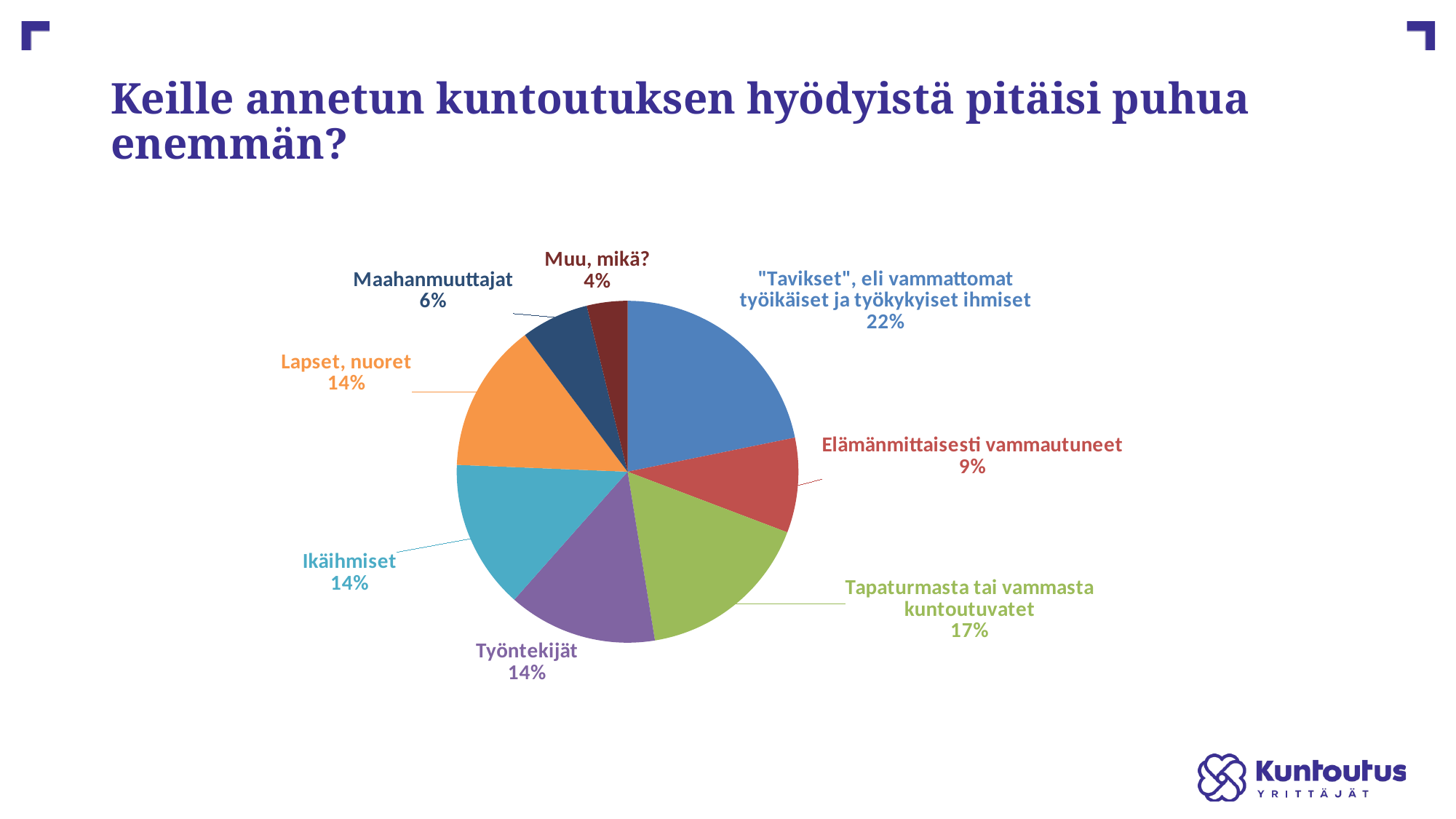
What kind of chart is shown on the slide? pie chart Which category has the smallest share of the pie? Muu, mikä? What share of the pie is labelled "Tavikset", eli vammattomat työikäiset ja työkykyiset ihmiset? 22% Which category has the largest share of the pie? "Tavikset", eli vammattomat työikäiset ja työkykyiset ihmiset What percentage is shown for Elämänmittaisesti vammautuneet? 9% How many slices does the pie chart have? 8 What is the title of the slide containing the pie chart? Keille annetun kuntoutuksen hyödyistä pitäisi puhua enemmän? What percentage is shown for Maahanmuuttajat? 6% What is the difference in percentage points between "Tavikset" (22%) and Tapaturmasta tai vammasta kuntoutuvatet (17%)? 5 percentage points Which is larger, the share for Elämänmittaisesti vammautuneet or the share for Maahanmuuttajat? Elämänmittaisesti vammautuneet What is the combined share of Lapset, nuoret, Ikäihmiset and Työntekijät? 42% What percentage is shown for Tapaturmasta tai vammasta kuntoutuvatet? 17%